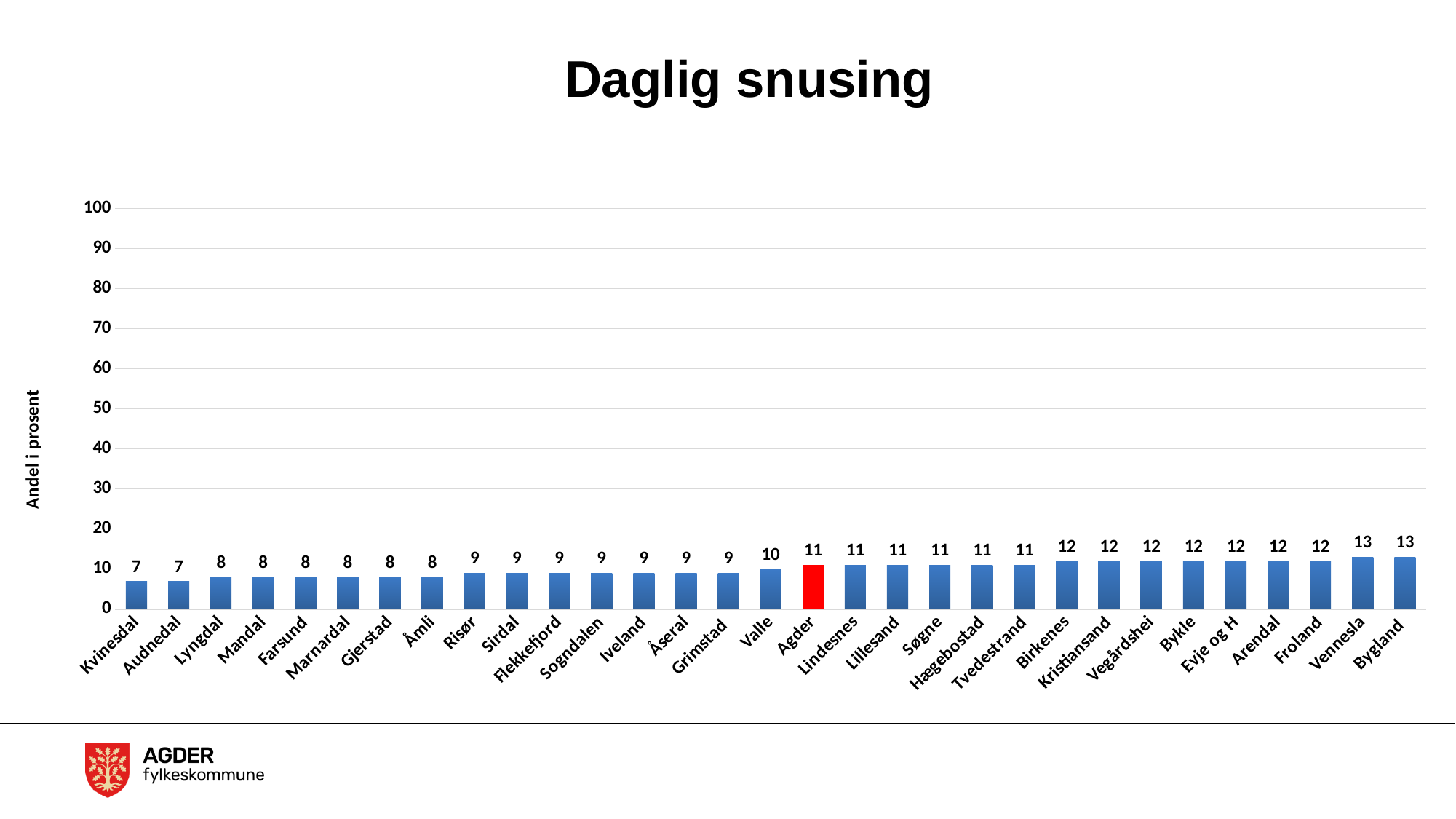
How many categories are shown on the x axis? 31 What is the difference between the values for Bygland and Kvinesdal? 6 Which has a larger value, Vennesla or Lyngdal? Vennesla What is the value for Kristiansand? 12 What is the value for Valle? 10 What is the value for Agder? 11 What is the value for Flekkefjord? 9 What kind of chart is shown on the slide? bar chart Is the value for Arendal greater or less than 20? less What is the highest value shown in the chart? 13 What is the lowest value shown in the chart? 7 Which bar is coloured red instead of blue? Agder